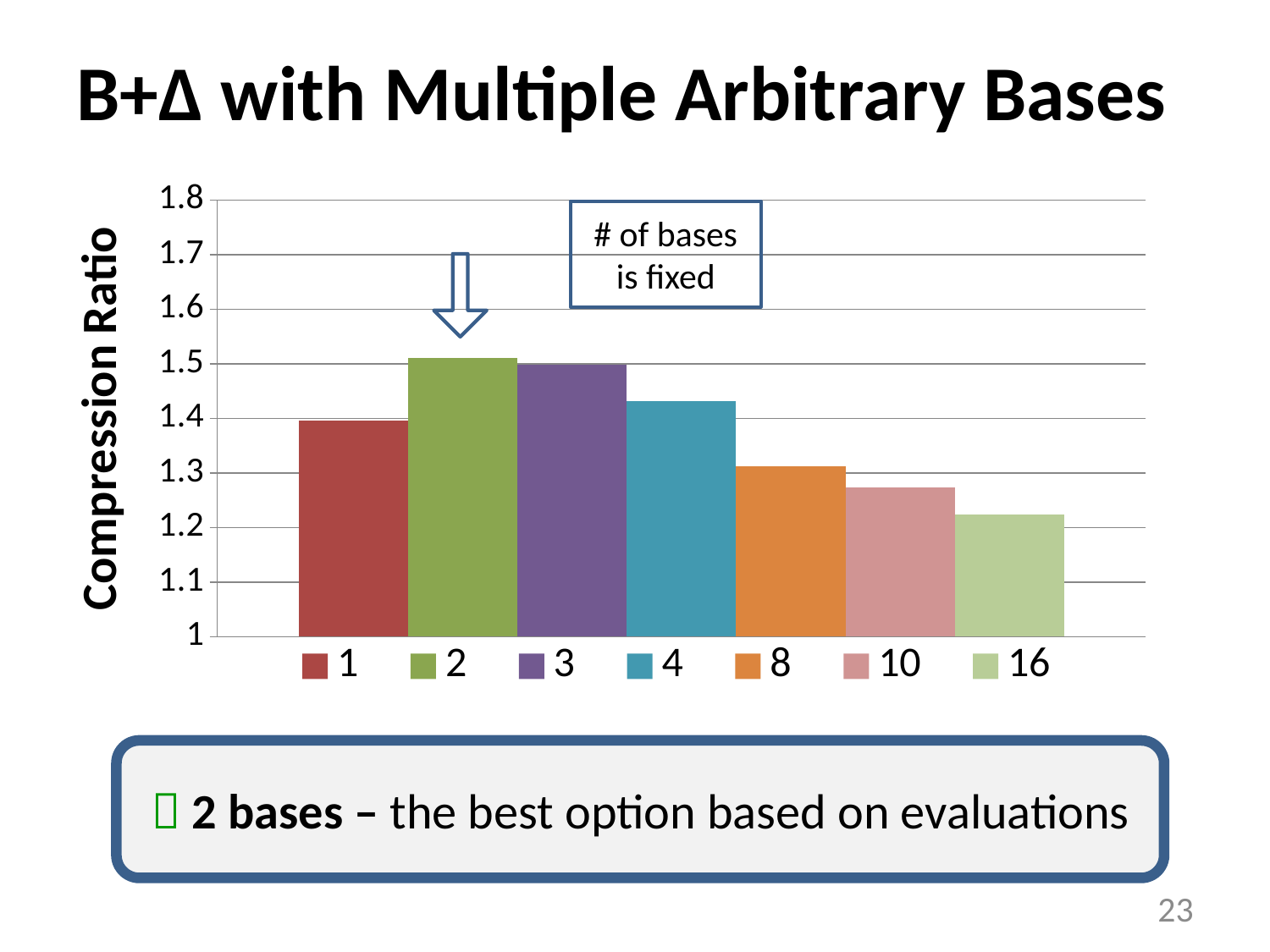
Is the compression ratio for 4 bases greater or less than 1.4? greater Which number of bases has the lowest compression ratio? 16 Is the compression ratio for 16 bases greater or less than 1.3? less How many bars are plotted in the chart? 7 Which number of bases has the highest compression ratio? 2 Do the compression ratios rise or fall from 2 bases through 16 bases? fall What is the label on the vertical axis of the chart? Compression Ratio What kind of chart is shown on the slide? bar chart Is the compression ratio for 8 bases greater or less than 1.4? less How many entries does the chart's legend list? 7 Which has a higher compression ratio, 4 bases or 8 bases? 4 bases